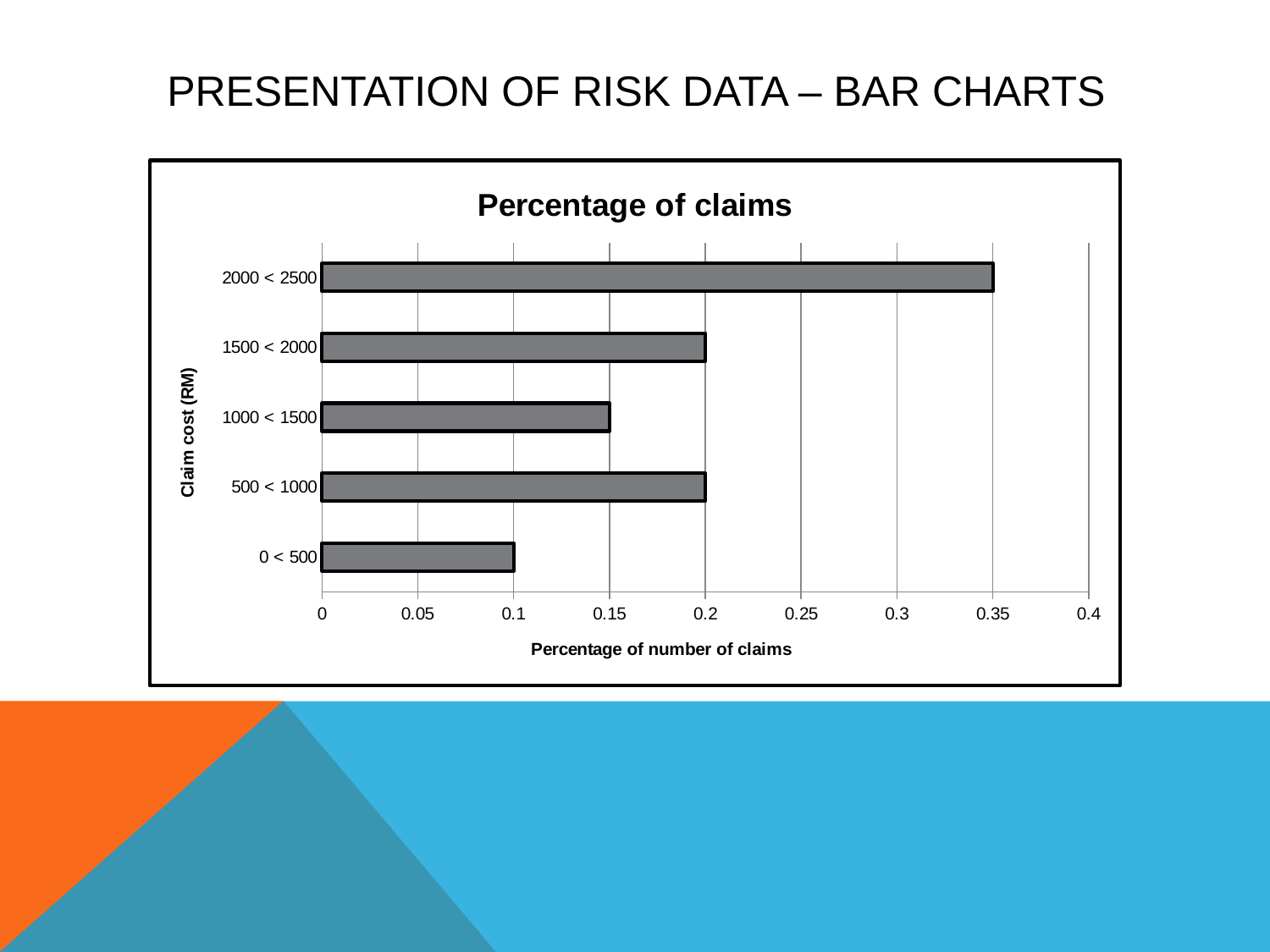
What is the value for the 2000 < 2500 claim cost category? 0.35 Which is larger, the value for 500 < 1000 or the value for 1000 < 1500? 500 < 1000 Which claim cost category has the highest percentage of claims? 2000 < 2500 Which claim cost category has the lowest percentage of claims? 0 < 500 What type of chart is shown on the slide? Bar chart What is the difference between the values for 2000 < 2500 and 1500 < 2000? 0.15 What is the label of the horizontal axis? Percentage of number of claims What is the title of the chart? Percentage of claims What is the value for the 0 < 500 claim cost category? 0.1 What is the value for the 1000 < 1500 claim cost category? 0.15 How many claim cost categories are plotted in the chart? 5 Is the value for 2000 < 2500 greater or less than 0.3? greater